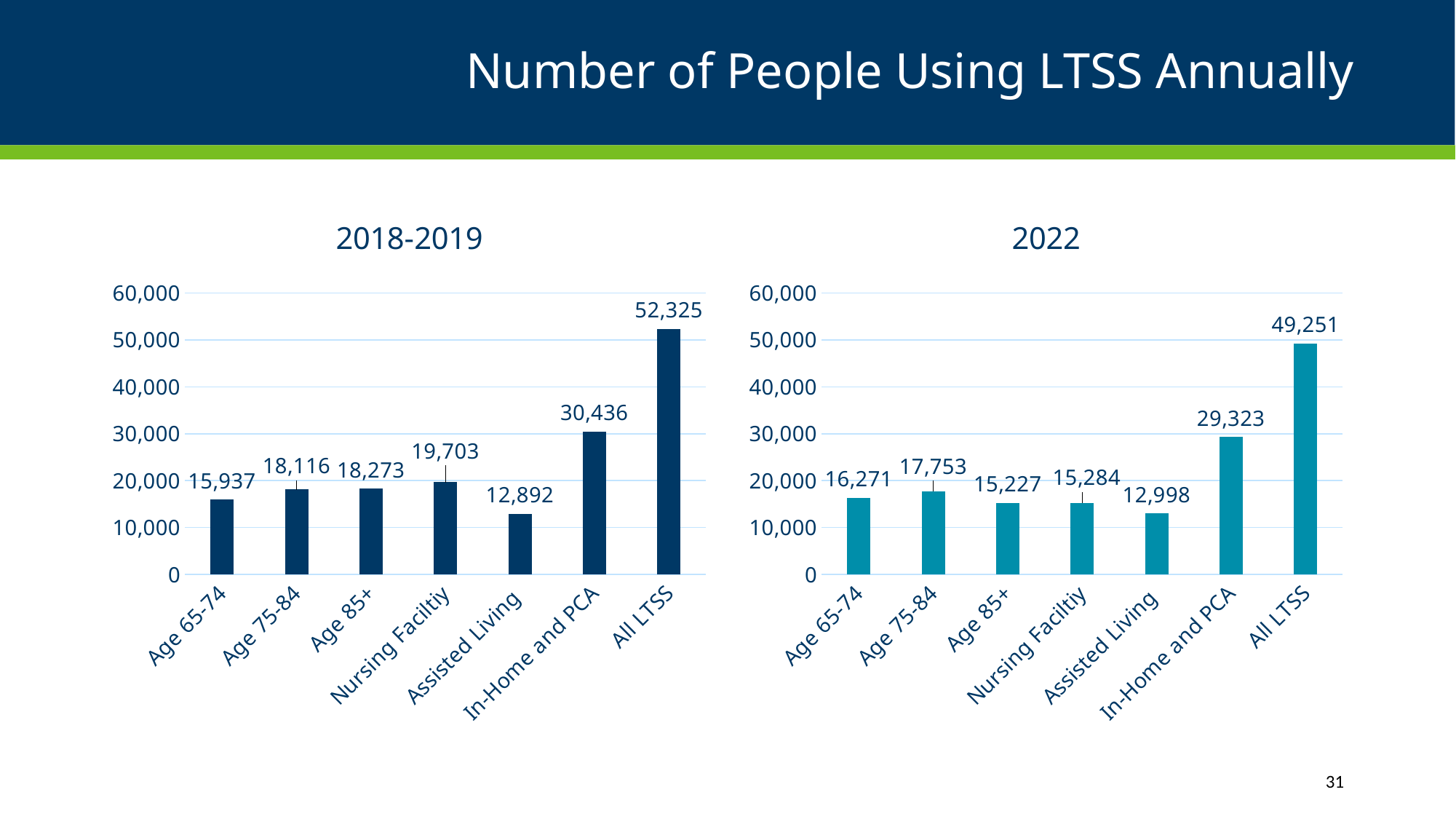
In the 2018-2019 chart, what is the value for All LTSS? 52,325 How many categories are shown in the 2022 chart? 7 In the 2018-2019 chart, which category has the lowest value? Assisted Living In the 2022 chart, what is the value for In-Home and PCA? 29,323 In the 2022 chart, which category has the highest value? All LTSS In the 2022 chart, what is the difference between Age 75-84 and Age 65-74? 1,482 In the 2022 chart, what is the value for Age 85+? 15,227 In the 2018-2019 chart, which is larger, Nursing Faciltiy or Age 85+? Nursing Faciltiy In the 2018-2019 chart, what is the difference between All LTSS and In-Home and PCA? 21,889 What kind of chart is the 2018-2019 chart? bar chart In the 2022 chart, is the value for Assisted Living greater or less than 20,000? less What is the title of the chart on the right side of the slide? 2022